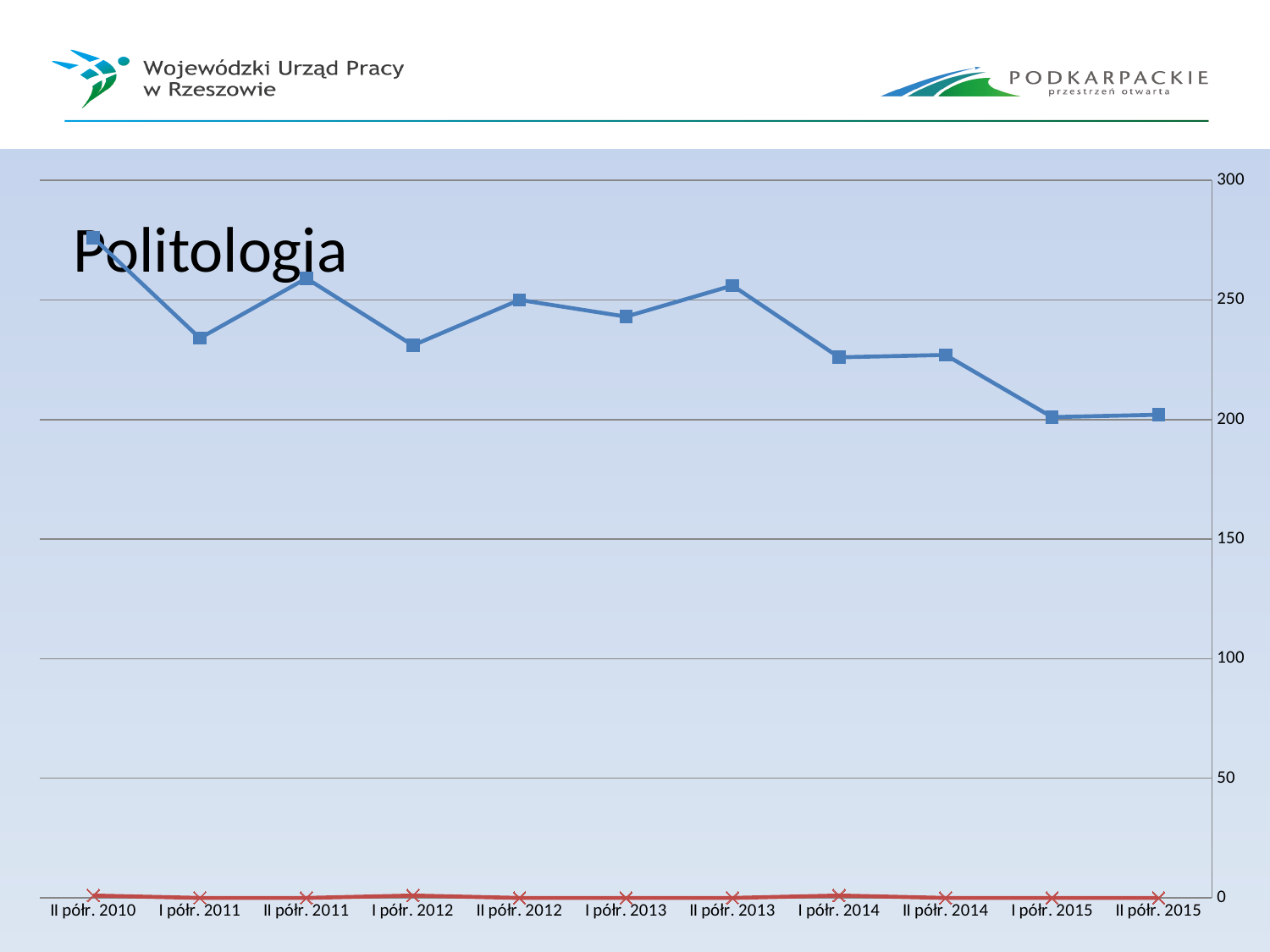
In which period does the blue line reach its highest value? II półr. 2010 Which is larger on the blue line: the value for II półr. 2010 or the value for I półr. 2011? II półr. 2010 Which is larger on the blue line: the value for I półr. 2012 or the value for II półr. 2012? II półr. 2012 Is the blue line's value for I półr. 2011 greater or less than 250? less What is the title shown on the chart? Politologia Is the blue line's value for II półr. 2010 greater or less than 250? greater How many periods are shown along the x axis? 11 Overall, does the blue line rise or fall from II półr. 2010 to II półr. 2015? fall Is the blue line's value for I półr. 2012 greater or less than 250? less What kind of chart is shown on the slide? line chart